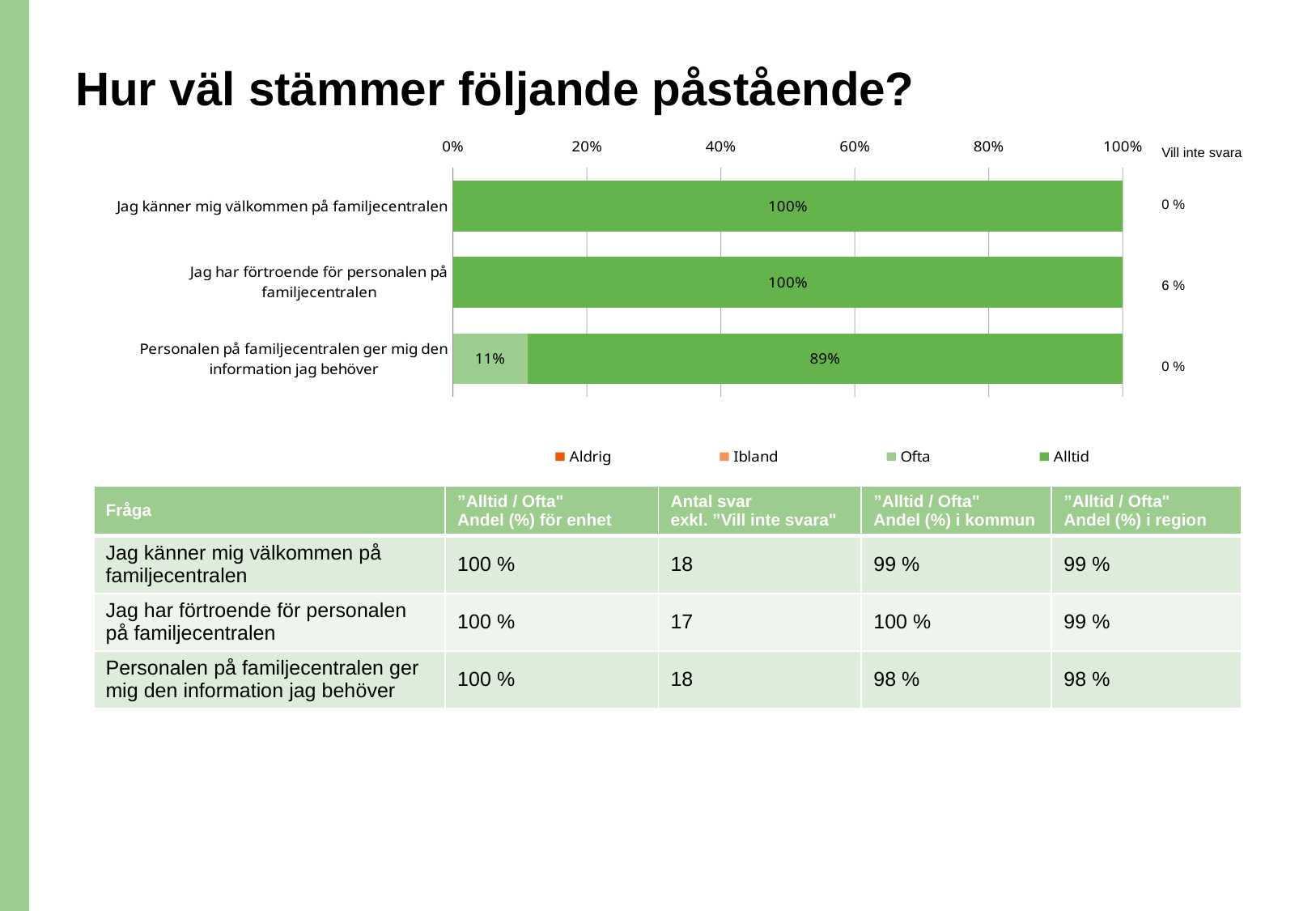
How many series does the chart legend list? 4 What is the "Alltid" value for "Personalen på familjecentralen ger mig den information jag behöver"? 89% Which legend entry is shown in the darkest green colour? Alltid Which is larger for "Personalen på familjecentralen ger mig den information jag behöver": the "Ofta" value or the "Alltid" value? Alltid What is the "Alltid" value for "Jag känner mig välkommen på familjecentralen"? 100% What is the difference between the "Alltid" and "Ofta" values for "Personalen på familjecentralen ger mig den information jag behöver"? 78% What is the "Alltid" value for "Jag har förtroende för personalen på familjecentralen"? 100% What kind of chart is shown on the slide? bar chart What is the "Vill inte svara" value shown next to the bar for "Jag har förtroende för personalen på familjecentralen"? 6 % Which statement has the lowest "Alltid" value? Personalen på familjecentralen ger mig den information jag behöver How many statements (categories) are plotted in the chart? 3 What is the "Ofta" value for "Personalen på familjecentralen ger mig den information jag behöver"? 11%